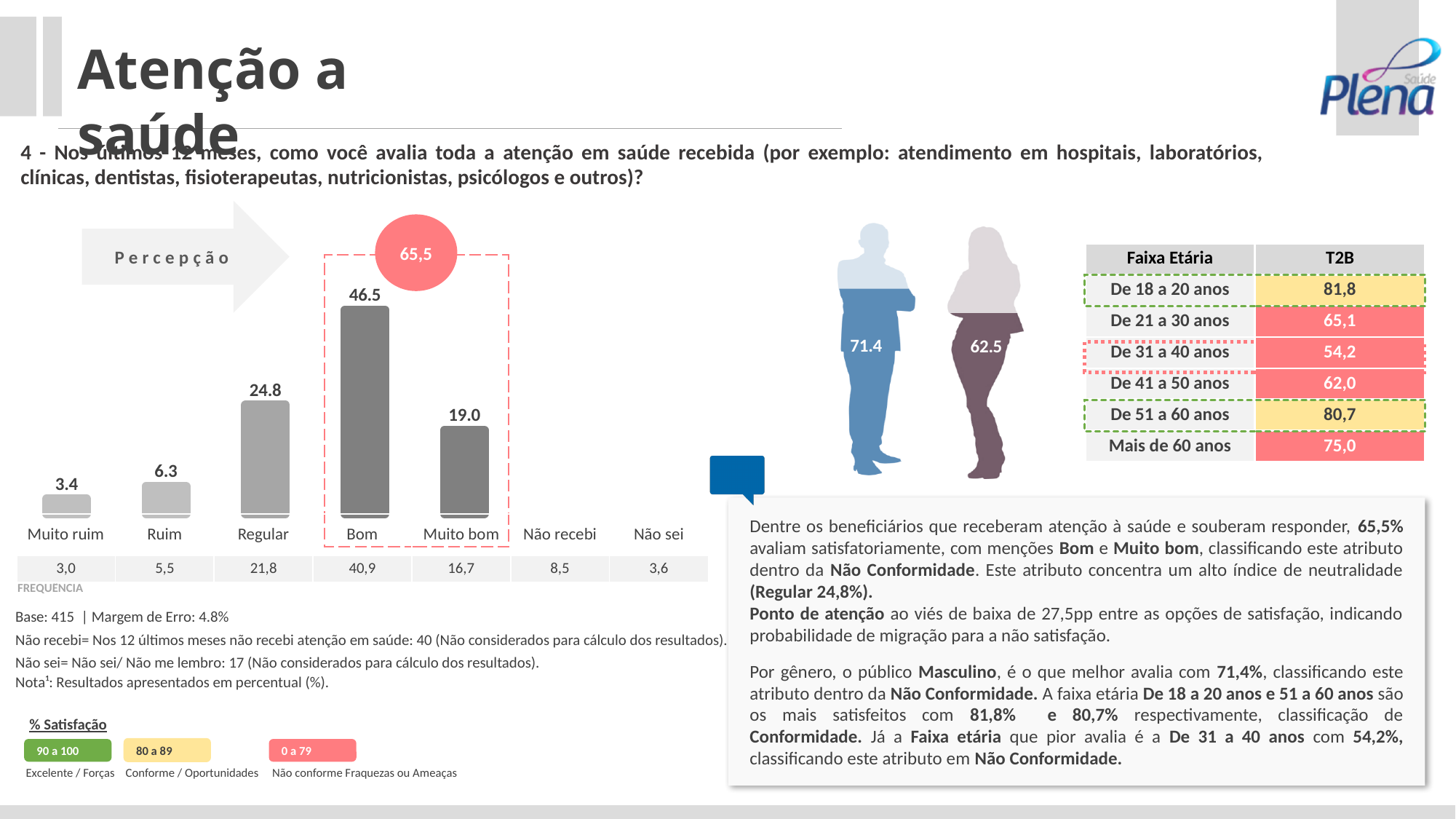
Which category has the highest bar in the chart? Bom Which category has the lowest bar in the chart? Muito ruim What is the value for Regular in the bar chart? 24.8 What kind of chart is shown on the left of the slide? bar chart Which two categories are enclosed by the red dashed box in the bar chart? Bom and Muito bom What is the value for Bom in the bar chart? 46.5 Which is larger in the bar chart, Regular or Muito bom? Regular What is the value for Muito ruim in the bar chart? 3.4 What is the difference between the values for Bom and Muito bom in the bar chart? 27.5 In the frequency row below the bar chart, what is the value for Não recebi? 8,5 What is the combined value of Bom and Muito bom shown in the circle above the dashed box? 65,5 How many bars are plotted in the bar chart? 5